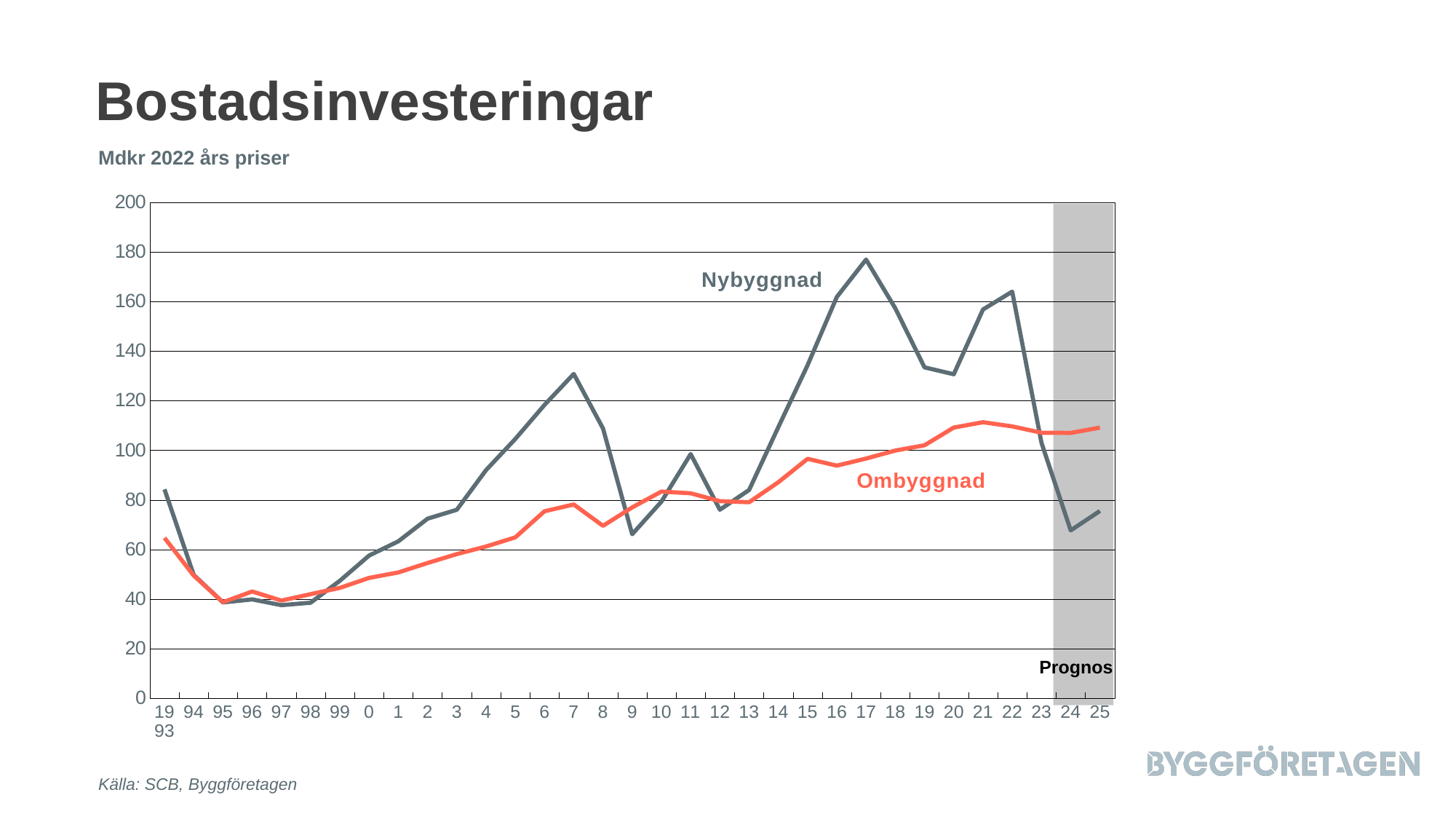
What label is shown on the shaded area at the right of the chart? Prognos Which series has the higher value in 2024, Nybyggnad or Ombyggnad? Ombyggnad In which year does the Nybyggnad series reach its highest value? 2017 Is the value for Ombyggnad in 2021 greater or less than 100? greater Which series has the higher value in 2017, Nybyggnad or Ombyggnad? Nybyggnad How many series are plotted on the chart? 2 Is the value for Nybyggnad in 2009 greater or less than 80? less Is the value for Nybyggnad in 2017 greater or less than 160? greater What kind of chart is shown on the slide? Line chart Does the Nybyggnad series rise or fall between 2022 and 2024? Fall Which series is drawn in red/orange? Ombyggnad